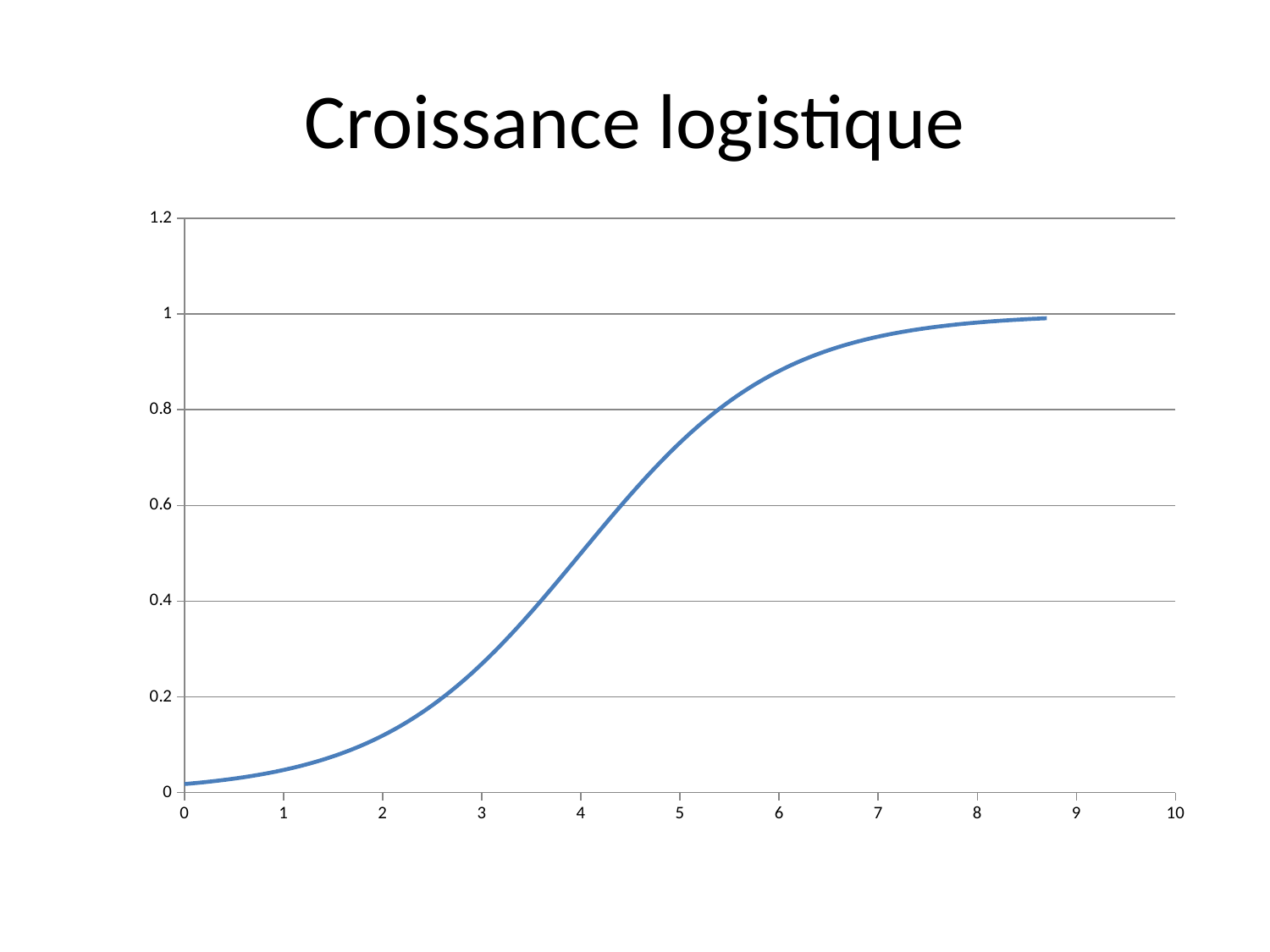
What is the highest value shown on the vertical axis? 1.2 What kind of chart is shown on the slide? line chart Is the value of the curve at x = 2 greater or less than 0.2? less Is the value of the curve at x = 6 greater or less than 0.8? greater How many lines are plotted on the chart? 1 Is the value of the curve at x = 0 greater or less than 0.2? less Do the values rise or fall as x increases from 0 to 9? rise What is the title of the chart? Croissance logistique